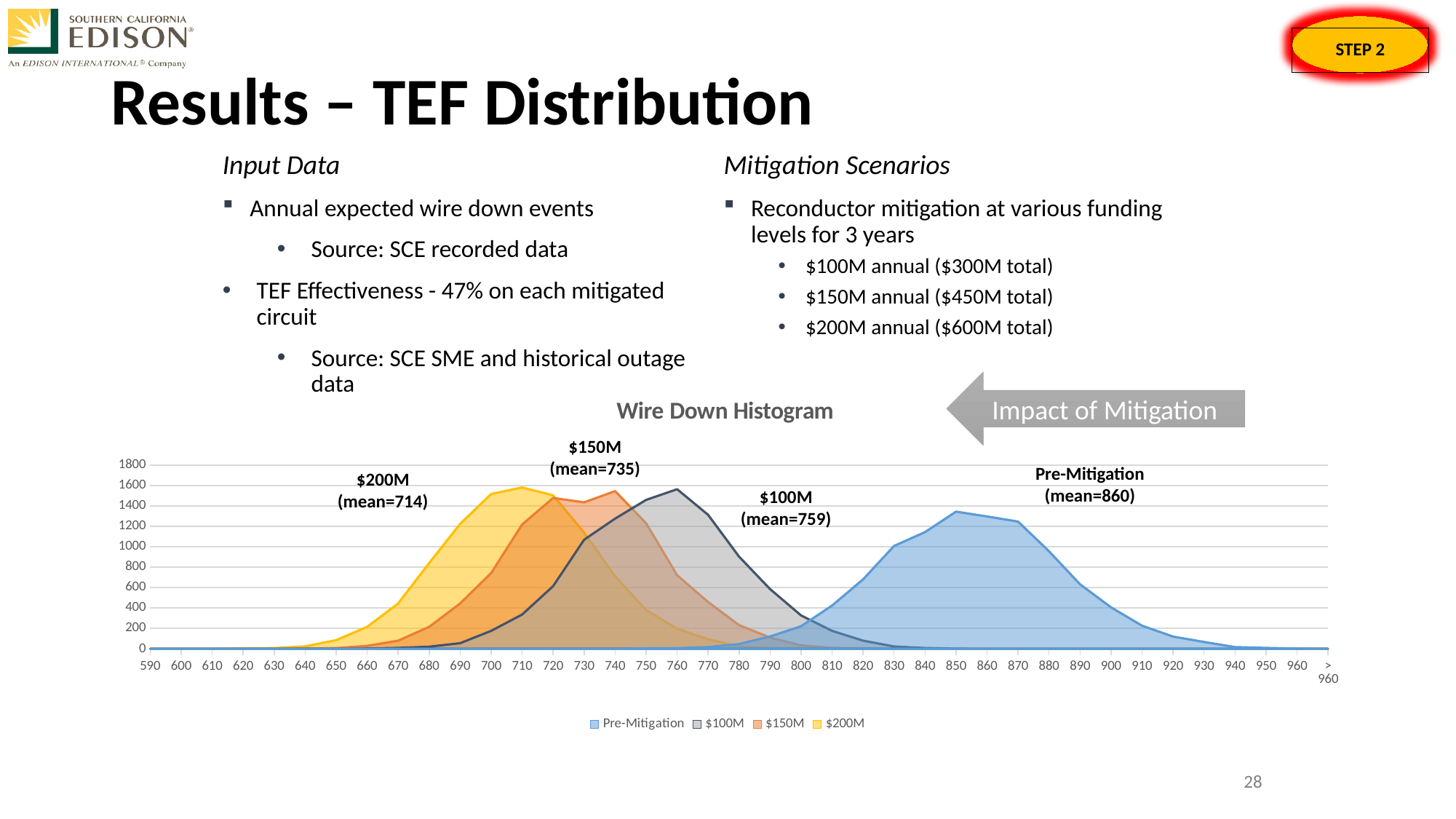
Is the peak value of the Pre-Mitigation series greater or less than 1200? greater What is the title of the chart on the slide? Wire Down Histogram What is the mean shown for the Pre-Mitigation series? 860 What is the mean shown for the $100M series? 759 What is the difference between the Pre-Mitigation mean and the $200M mean? 146 How many series does the chart legend list? 4 Which series reaches a higher peak, Pre-Mitigation or $200M? $200M Which series has the lowest mean shown on the chart? $200M What is the mean shown for the $200M series? 714 What kind of chart is the Wire Down Histogram? Area chart Do the Pre-Mitigation values rise or fall along the x axis from 850 to 960? fall What is the mean shown for the $150M series? 735